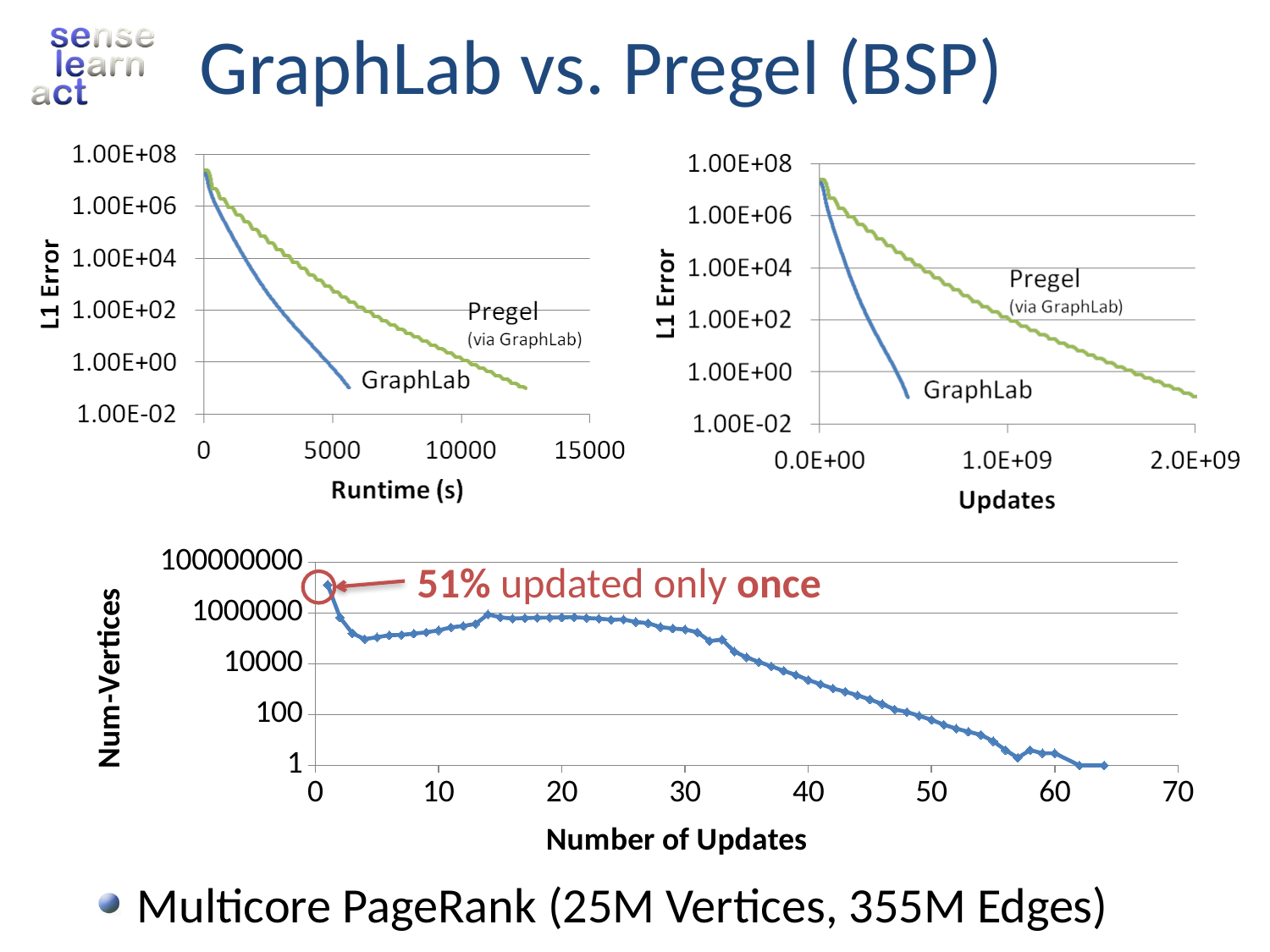
In the top-left chart, does the L1 Error rise or fall as Runtime increases? fall In the bottom chart (Num-Vertices vs Number of Updates), is the value at 60 updates greater or less than 100? less In the bottom chart, does Num-Vertices generally rise or fall as Number of Updates increases beyond 30? fall In the top-right chart (L1 Error vs Updates), which series needs more updates to reach the same L1 Error, GraphLab or Pregel? Pregel What kind of chart is the top-left chart with the x axis labelled Runtime (s)? line chart In the top-right chart (L1 Error vs Updates), is the number of updates at which the GraphLab curve ends greater or less than 1.0E+09? less What is the y-axis label of the bottom chart? Num-Vertices What is the x-axis label of the top-right chart? Updates In the bottom chart (Num-Vertices vs Number of Updates), is the value at 1 update greater or less than 1000000? greater In the top-left chart (L1 Error vs Runtime), how many series are plotted? 2 In the top-left chart (L1 Error vs Runtime), which series reaches the bottom of its curve at a smaller runtime, GraphLab or Pregel? GraphLab